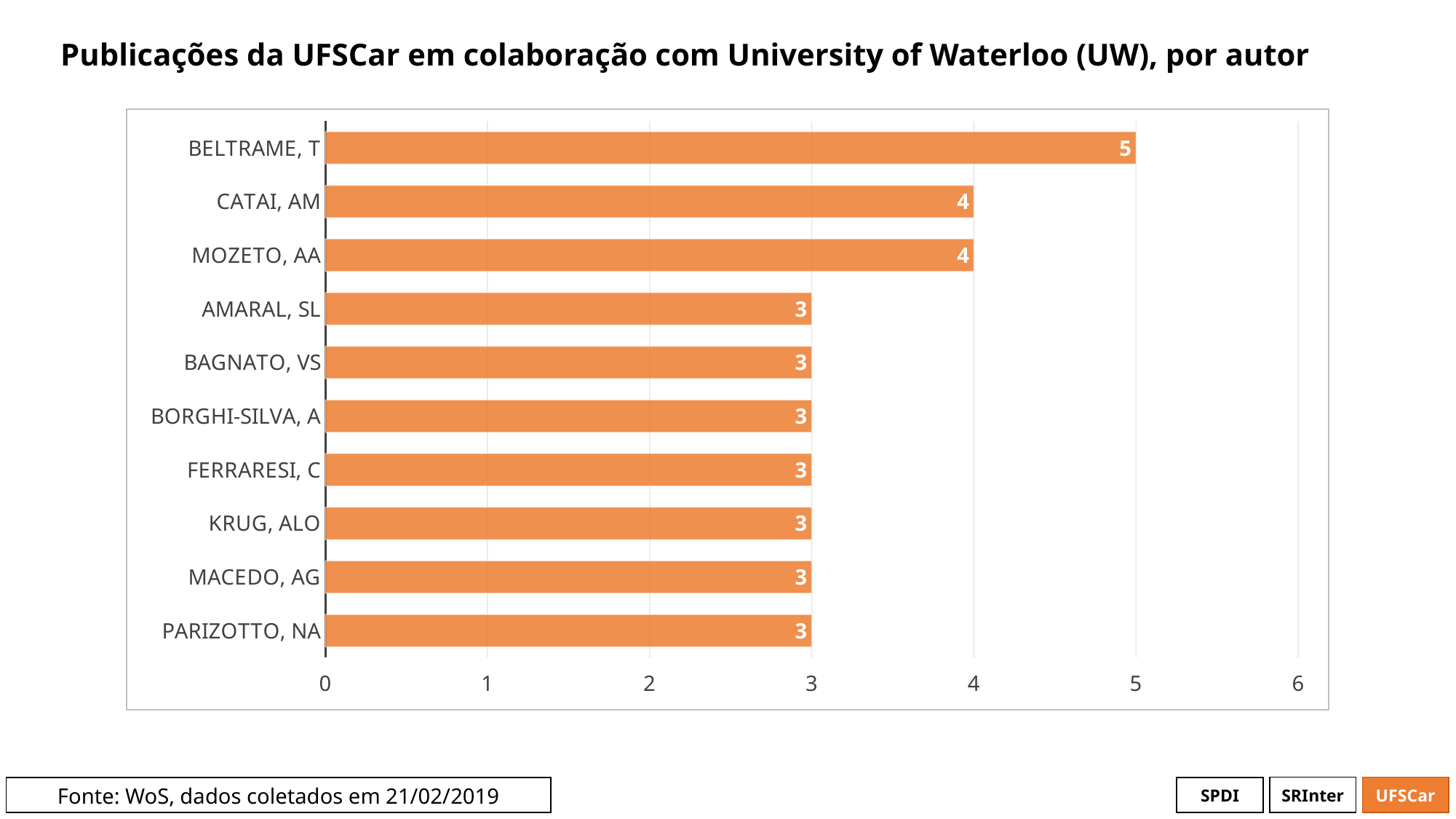
How many publications does BELTRAME, T have? 5 Which is larger, the value for BELTRAME, T or the value for KRUG, ALO? BELTRAME, T What is the difference between the values for BELTRAME, T and MOZETO, AA? 1 What is the value for PARIZOTTO, NA? 3 How many authors have a value of 3? 7 What is the difference between the values for CATAI, AM and AMARAL, SL? 1 What is the value for CATAI, AM? 4 What is the title of the chart? Publicações da UFSCar em colaboração com University of Waterloo (UW), por autor Which author has the highest number of publications? BELTRAME, T Is the value for BELTRAME, T greater or less than 4? greater What kind of chart is shown on the slide? bar chart How many authors are shown in the chart? 10